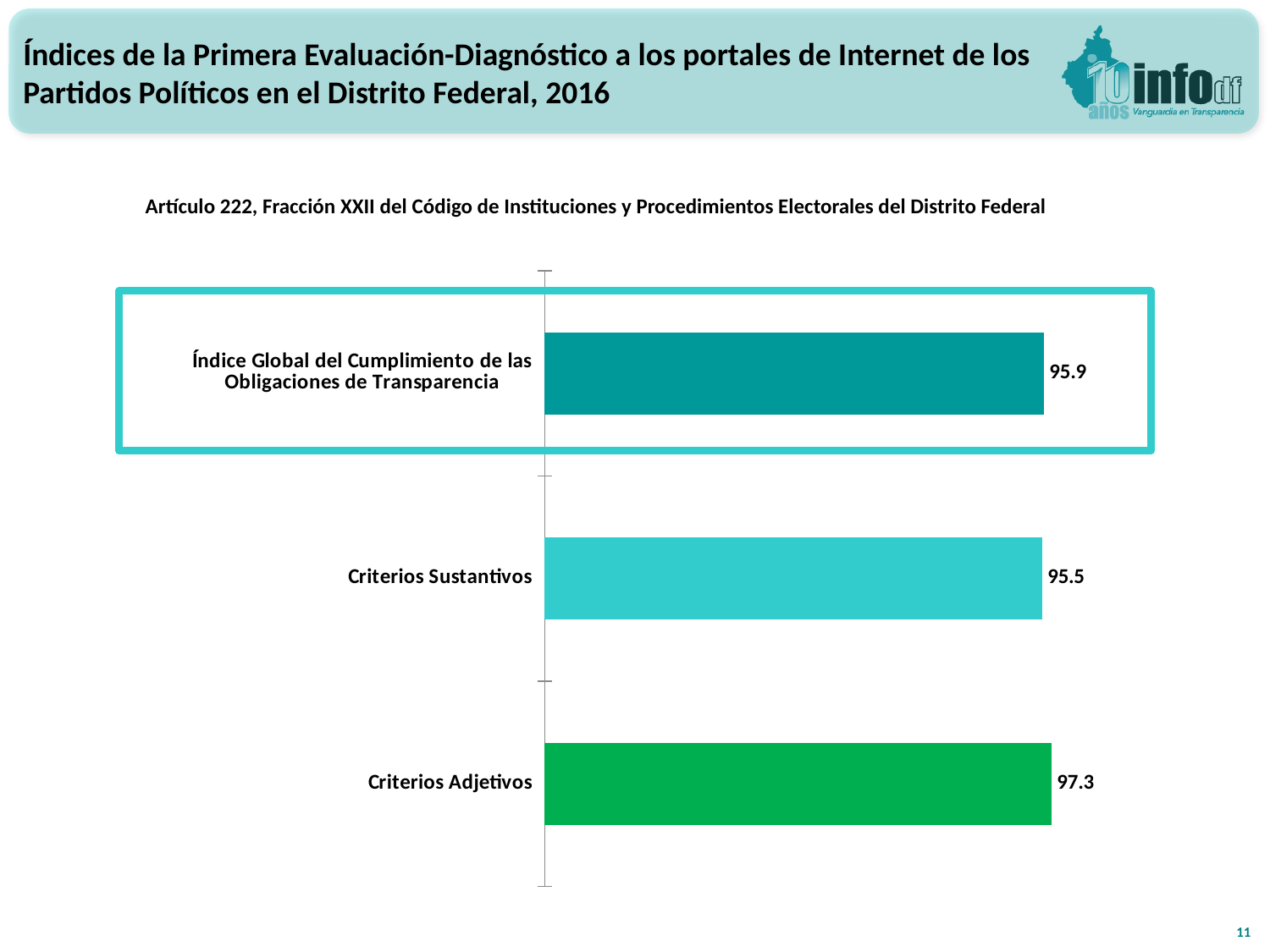
What is the difference between the values for Índice Global del Cumplimiento de las Obligaciones de Transparencia and Criterios Sustantivos? 0.4 What kind of chart is shown on the slide? Bar chart How many categories are shown in the chart? 3 What is the difference between the values for Criterios Adjetivos and Criterios Sustantivos? 1.8 Which category has the highest value? Criterios Adjetivos Which category has the lowest value? Criterios Sustantivos Which category's bar is highlighted with a box around it? Índice Global del Cumplimiento de las Obligaciones de Transparencia Which is larger, the value for Criterios Adjetivos or the value for Índice Global del Cumplimiento de las Obligaciones de Transparencia? Criterios Adjetivos What is the title shown above the chart? Artículo 222, Fracción XXII del Código de Instituciones y Procedimientos Electorales del Distrito Federal What is the value for Criterios Adjetivos? 97.3 What is the value for Criterios Sustantivos? 95.5 What is the value for Índice Global del Cumplimiento de las Obligaciones de Transparencia? 95.9